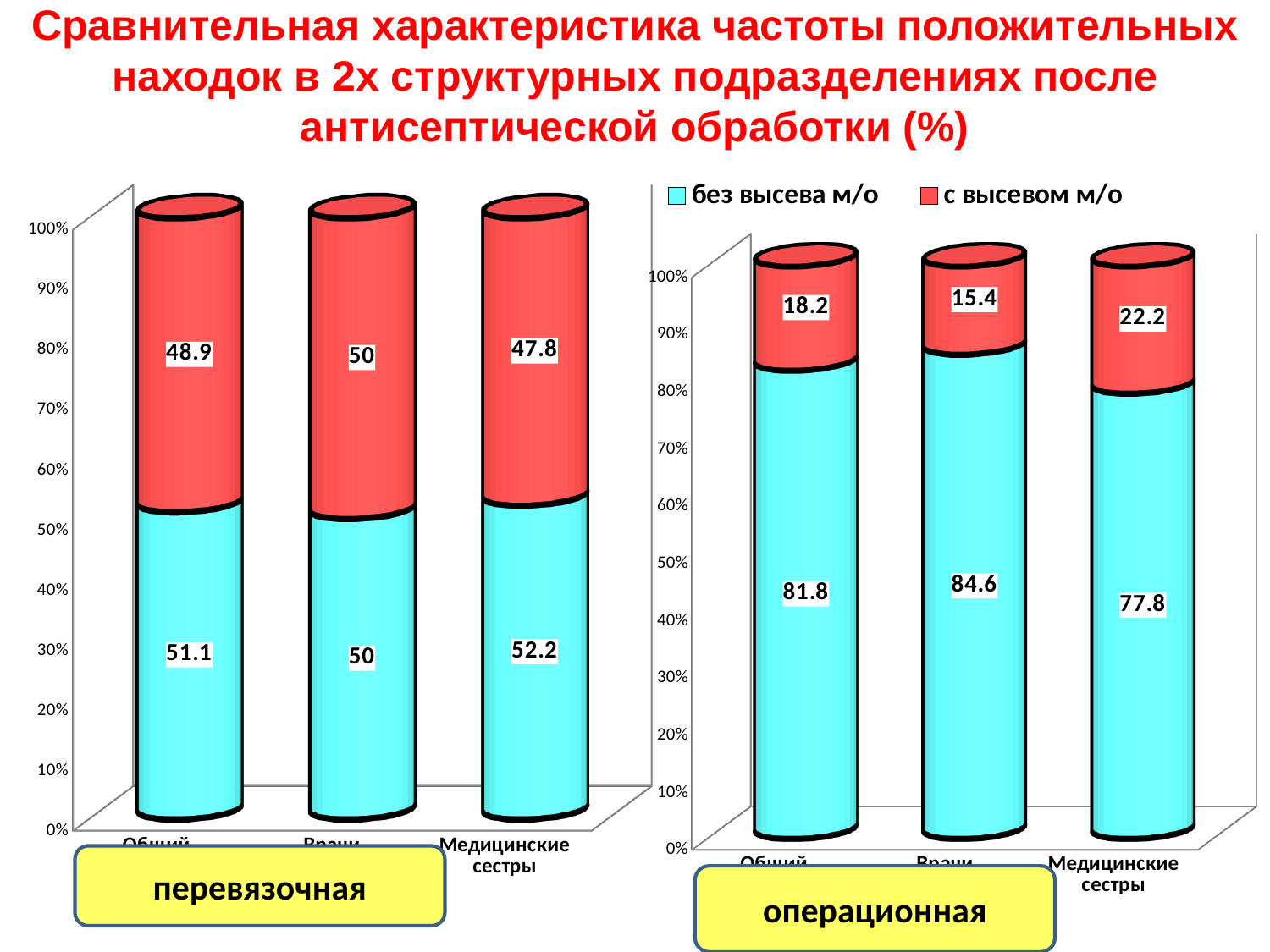
On the left (перевязочная) chart, what is the total of the stacked bar for Медицинские сестры? 100 On the left (перевязочная) chart, what is the value of 'с высевом м/о' for Медицинские сестры? 47.8 For Медицинские сестры, is the 'без высева м/о' value larger on the left (перевязочная) chart or on the right (операционная) chart? right (операционная) On the right (операционная) chart, is the 'без высева м/о' value of the leftmost bar greater or less than 80%? greater How many categories are shown on the right (операционная) chart? 3 On the left (перевязочная) chart, what is the difference between 'без высева м/о' and 'с высевом м/о' for Медицинские сестры? 4.4 On the right (операционная) chart, which category has the lowest value for 'без высева м/о'? Медицинские сестры On the right (операционная) chart, which category has the highest value for 'с высевом м/о'? Медицинские сестры On the right (операционная) chart, what is the value of 'без высева м/о' for Медицинские сестры? 77.8 What kind of chart is used on the left (перевязочная) chart? bar chart On the right (операционная) chart, what is the difference between 'без высева м/о' and 'с высевом м/о' for Медицинские сестры? 55.6 How many series does the legend list? 2